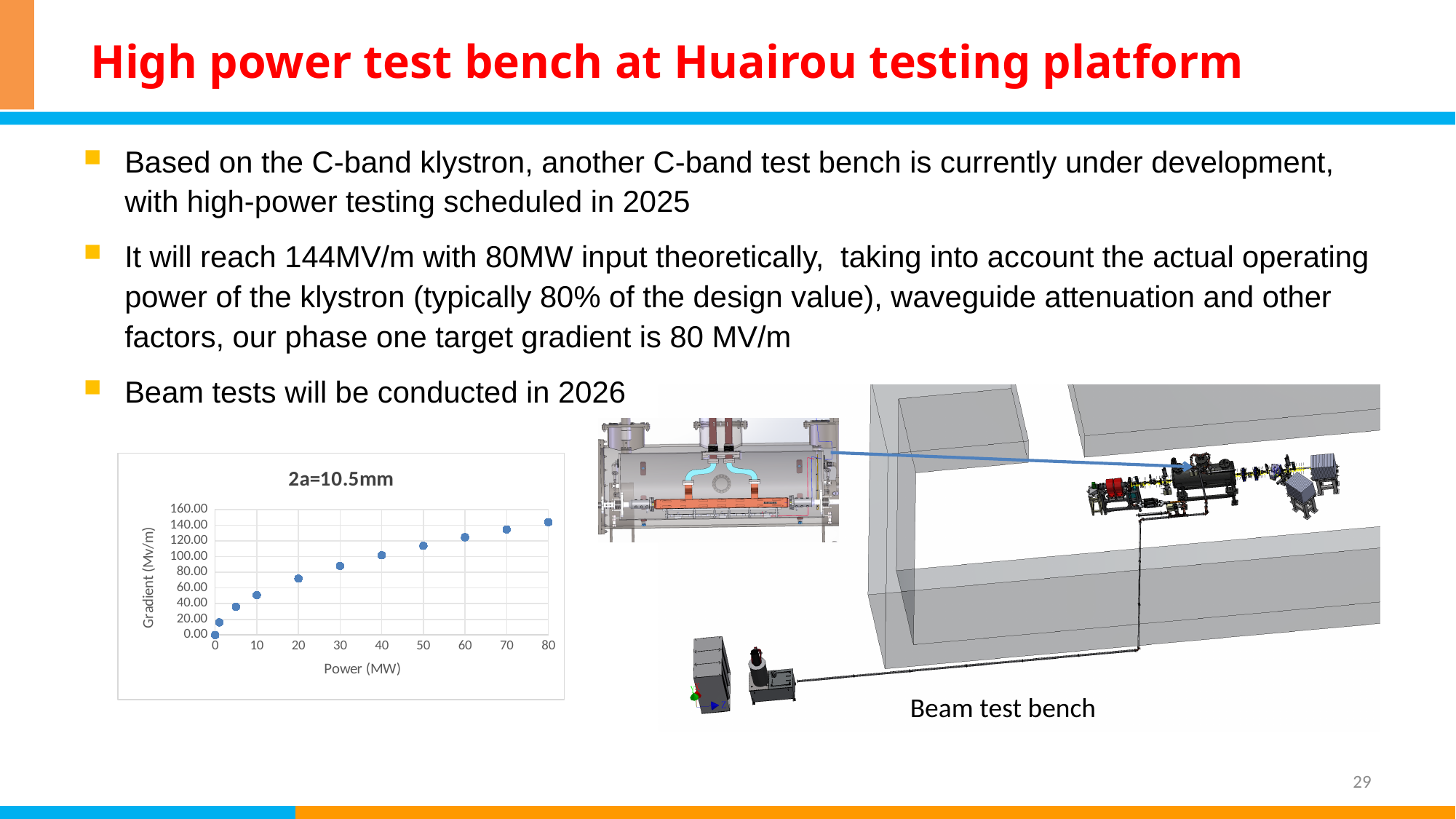
Is the gradient at 10 MW greater or less than 60.00? less Which has the larger gradient, 50 MW or 30 MW? 50 MW At which power value is the gradient highest? 80 At which power value is the gradient lowest? 0 Is the gradient at 30 MW greater or less than 100.00? less What is the label of the x axis of the chart? Power (MW) Is the gradient at 80 MW greater or less than 120.00? greater What kind of chart is shown on the slide? scatter chart What is the title of the chart? 2a=10.5mm Does the gradient rise or fall as power increases along the x axis? rise